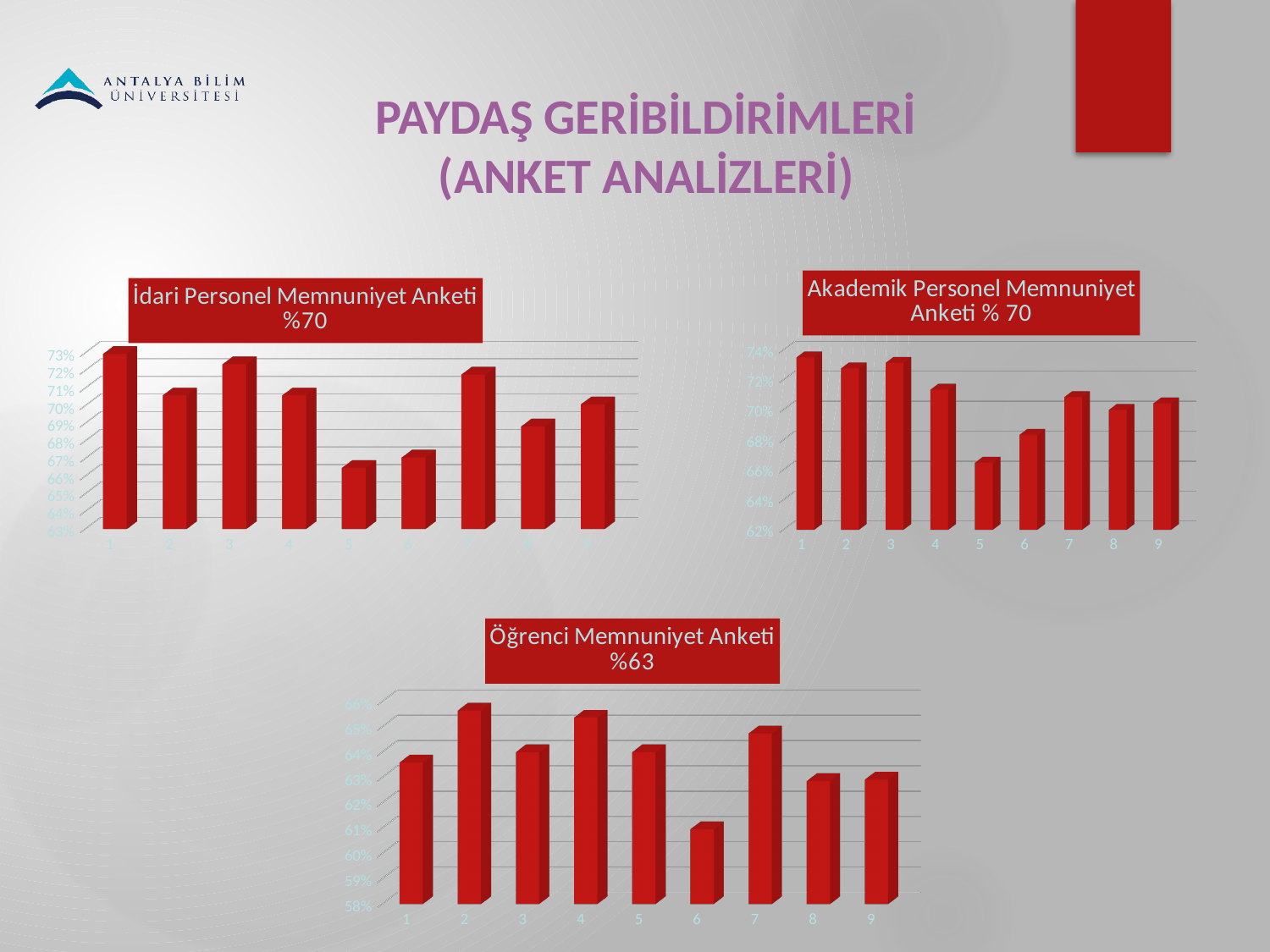
In the 'İdari Personel Memnuniyet Anketi %70' chart, which category has the lowest value? 5 What is the title of the chart at the bottom of the slide? Öğrenci Memnuniyet Anketi %63 In the 'Akademik Personel Memnuniyet Anketi % 70' chart, which is larger, the value for category 4 or the value for category 6? category 4 In the 'Öğrenci Memnuniyet Anketi %63' chart, which category has the highest value? 2 In the 'İdari Personel Memnuniyet Anketi %70' chart, which category has the highest value? 1 In the 'İdari Personel Memnuniyet Anketi %70' chart, how many categories are shown on the x axis? 9 What kind of chart is the 'İdari Personel Memnuniyet Anketi %70' chart? bar chart In the 'Akademik Personel Memnuniyet Anketi % 70' chart, which category has the lowest value? 5 In the 'Akademik Personel Memnuniyet Anketi % 70' chart, is the value for category 1 greater or less than 72%? greater In the 'Öğrenci Memnuniyet Anketi %63' chart, which category has the lowest value? 6 In the 'Öğrenci Memnuniyet Anketi %63' chart, is the value for category 6 greater or less than 62%? less In the 'İdari Personel Memnuniyet Anketi %70' chart, is the value for category 5 greater or less than 68%? less